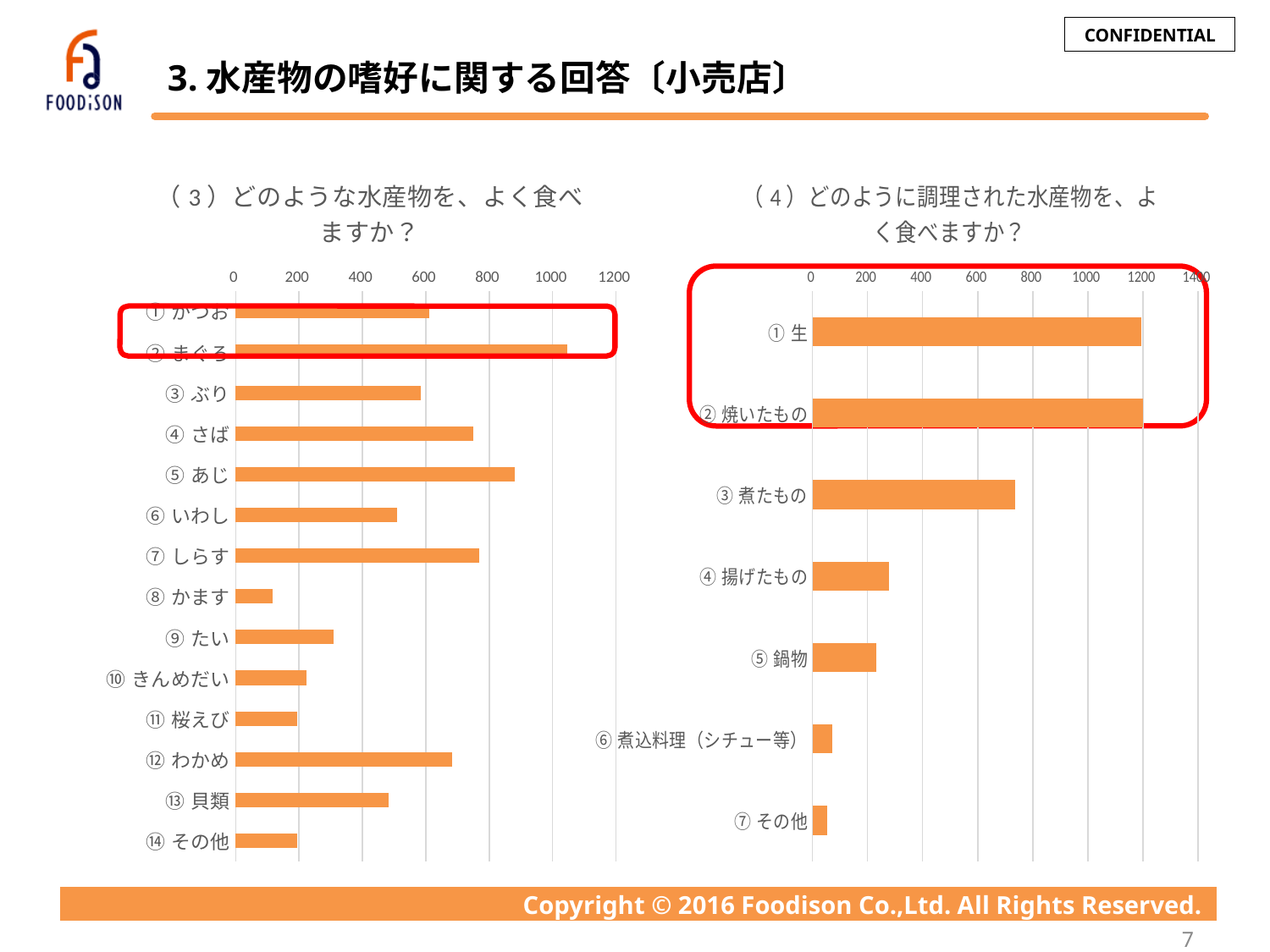
In the left chart (3), which category has the lowest value? ⑧ かます How many categories are shown in the left chart (3) どのような水産物を、よく食べますか？? 14 In the right chart (4), which is larger, the value for ① 生 or the value for ④ 揚げたもの? ① 生 How many categories are shown in the right chart (4) どのように調理された水産物を、よく食べますか？? 7 What is the maximum value shown on the horizontal axis of the right chart (4)? 1400 What type of chart is used for question (3) on the left side of the slide? bar chart In the right chart (4), is the value for ③ 煮たもの greater or less than 600? greater In the left chart (3), is the value for ② まぐろ greater or less than 1000? greater In the left chart (3), which category has the highest value? ② まぐろ In the right chart (4), is the value for ⑥ 煮込料理（シチュー等） greater or less than 200? less In the left chart (3), which is larger, the value for ⑤ あじ or the value for ③ ぶり? ⑤ あじ